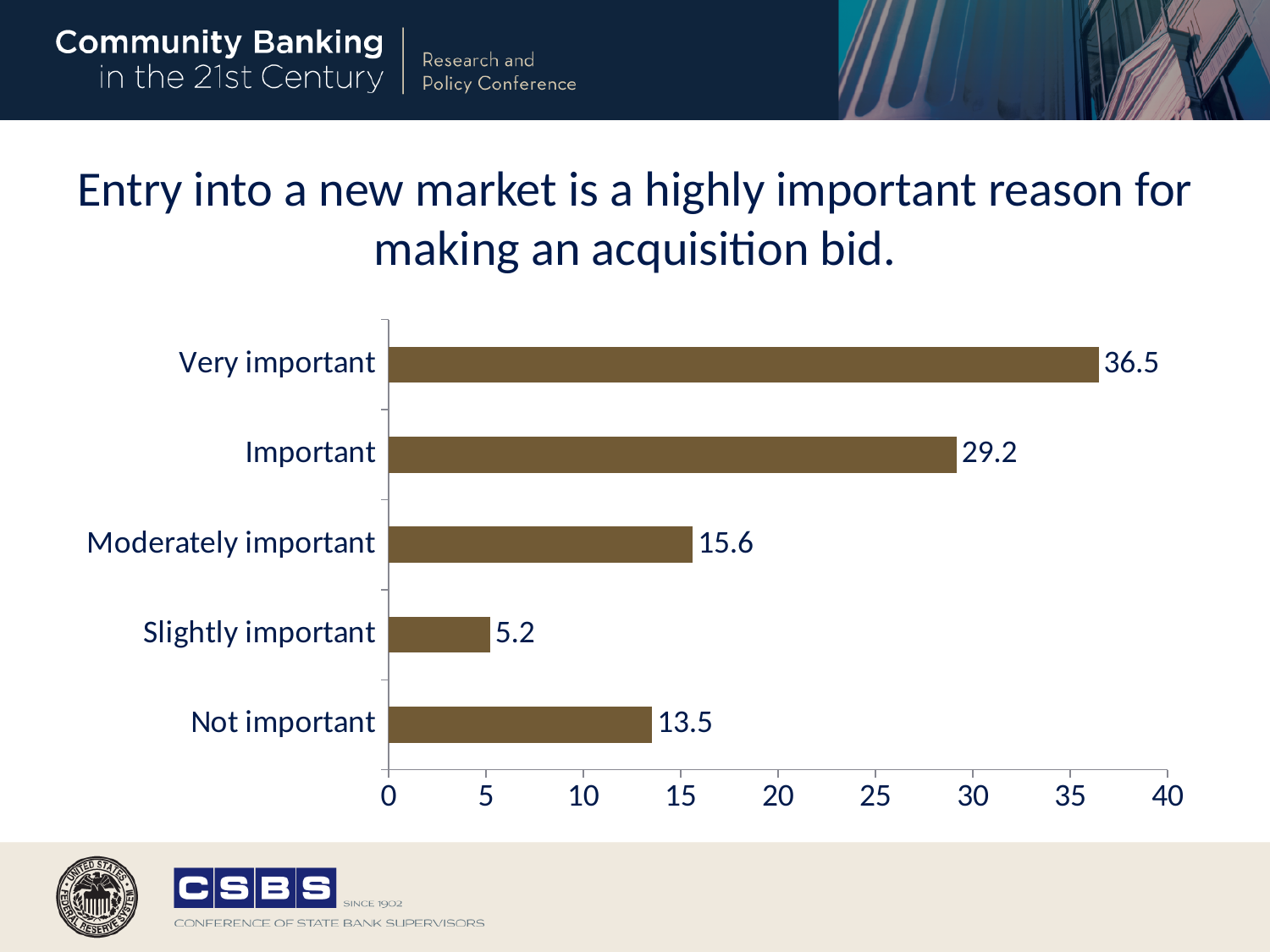
Which category has the lowest value? Slightly important Which category has the highest value? Very important What is the difference between the values for Very important and Important? 7.3 What is the value for Not important? 13.5 What is the value for Moderately important? 15.6 Is the value for Important greater or less than 25? greater What is the maximum value shown on the horizontal axis? 40 Which is larger, the value for Moderately important or the value for Not important? Moderately important What is the value for Very important? 36.5 How many categories are shown in the chart? 5 What is the difference between the values for Not important and Slightly important? 8.3 What kind of chart is shown on the slide? bar chart